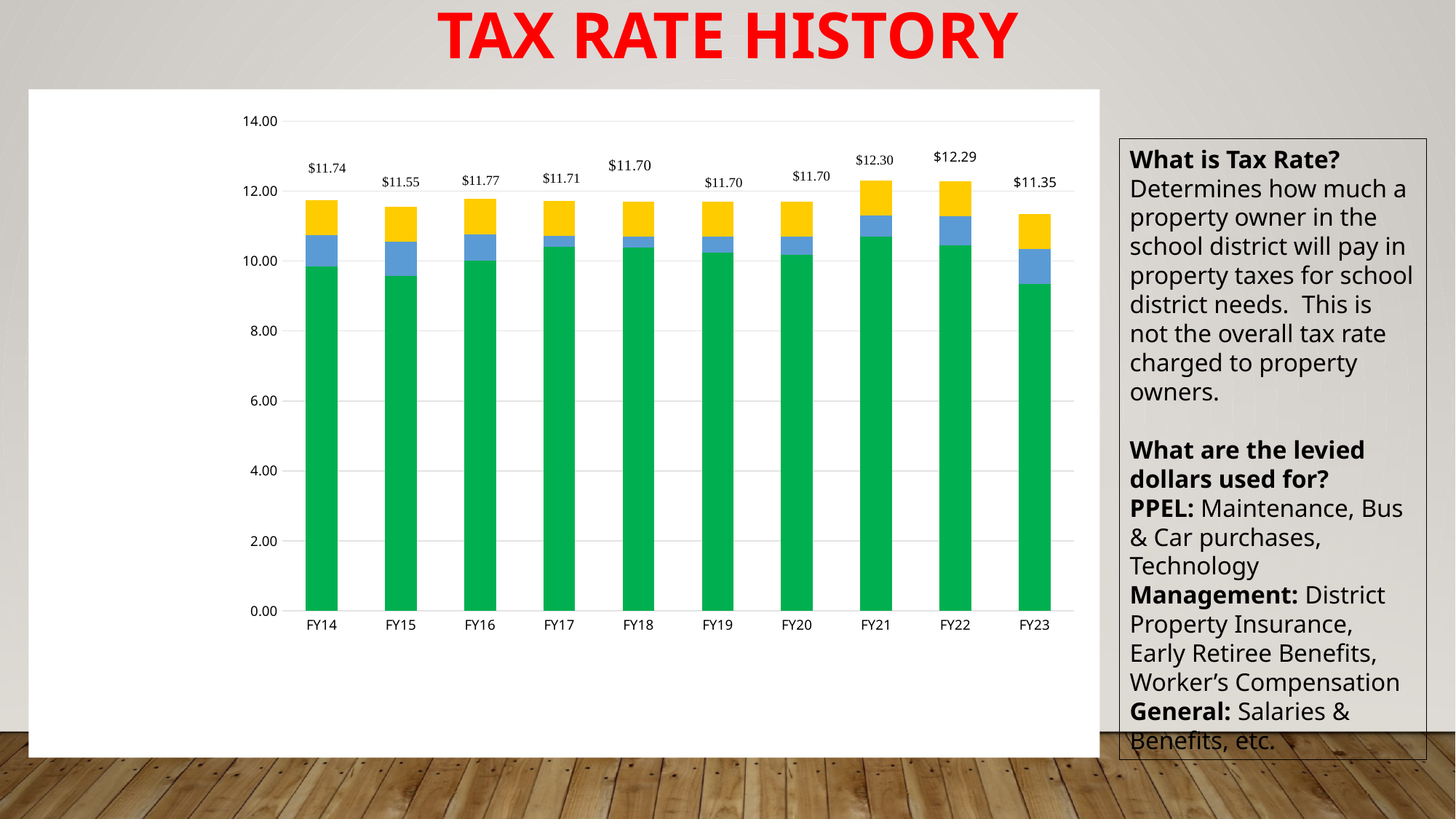
What is the total tax rate shown for FY23? $11.35 What kind of chart is shown on the slide? Stacked bar chart Which fiscal year has the lowest total tax rate? FY23 Which has a larger total tax rate, FY16 or FY15? FY16 Which fiscal year has the highest total tax rate? FY21 What is the difference between the total tax rate for FY14 and FY15? $0.19 What is the total tax rate shown for FY21? $12.30 What is the total tax rate shown for FY14? $11.74 How many fiscal years are shown on the x axis? 10 Is the green segment for FY23 greater or less than 10.00? less What is the difference between the total tax rate for FY21 and FY23? $0.95 What is the title of the slide containing the chart? Tax Rate History